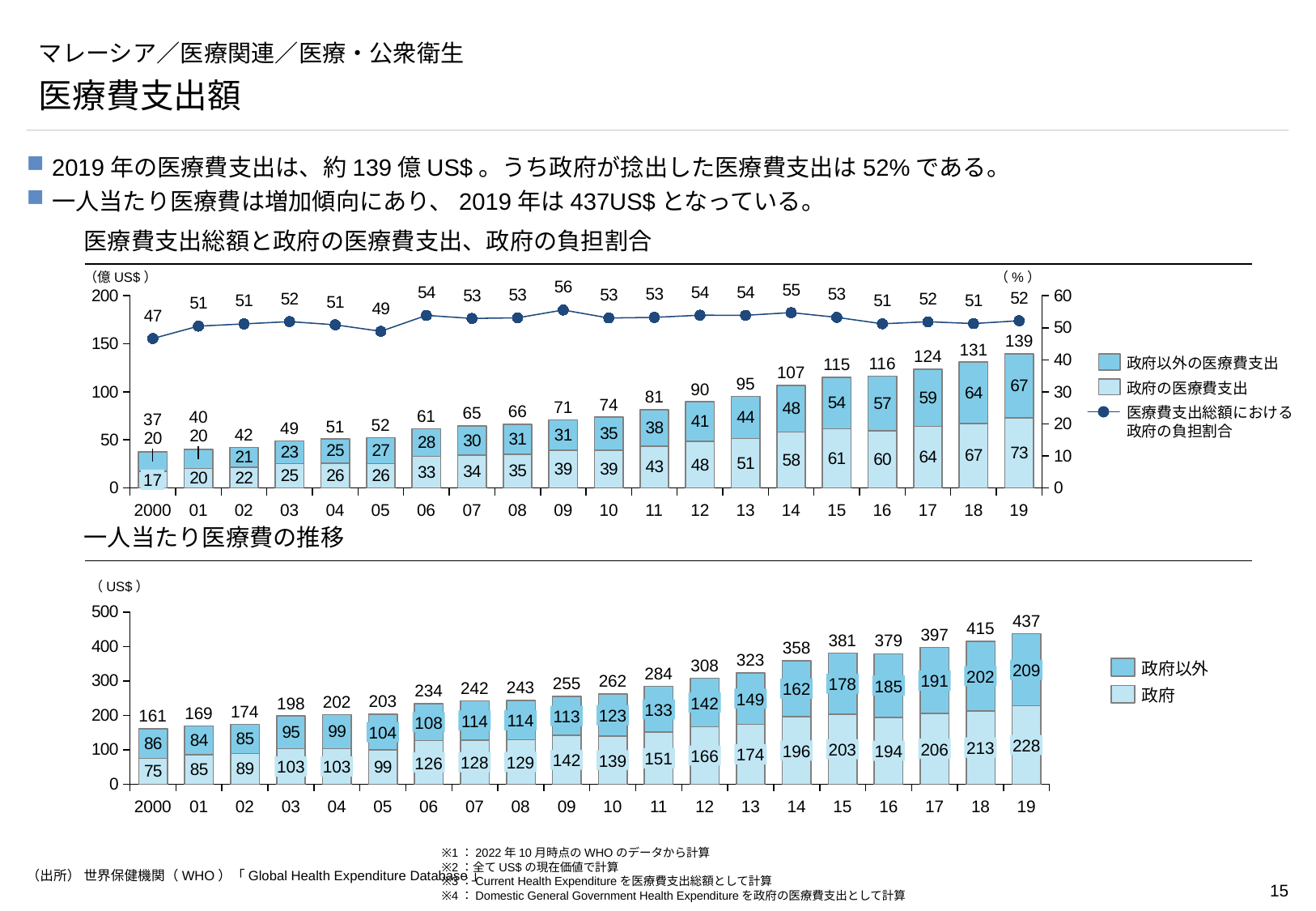
In the bottom chart, what is the 政府 value for 2016? 194 In the top chart, in which year is the government's share (政府の負担割合) highest? 2009 How many years are plotted in the bottom chart? 20 In the top chart, what is the difference between the total health expenditure in 2019 and in 2018? 8 How many series does the legend of the top chart list? 3 In the top chart, what is the value of 政府の医療費支出 for 2014? 58 In the bottom chart, which is larger in 2000: 政府 or 政府以外? 政府以外 What kind of chart is the bottom chart (一人当たり医療費の推移)? Stacked bar chart In the top chart (医療費支出総額と政府の医療費支出、政府の負担割合), what is the total health expenditure (億 US$) for 2019? 139 In the top chart, in which year is the government's share (政府の負担割合) lowest? 2000 In the bottom chart (一人当たり医療費の推移), what is the per-capita health expenditure for 2019? 437 In the bottom chart, do the per-capita totals generally rise or fall from 2000 to 2019? Rise